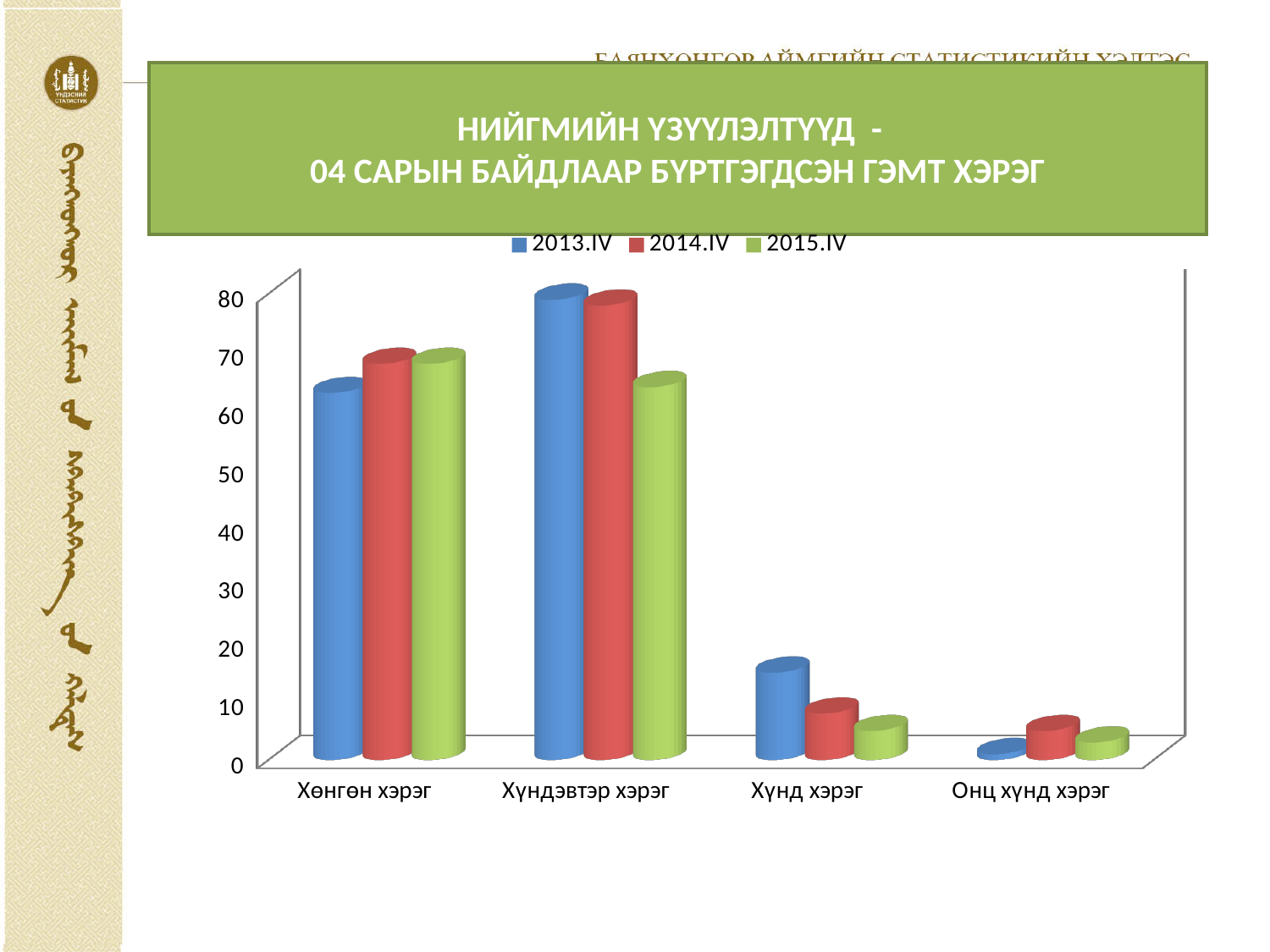
Which category has the highest value for the 2013.IV series? Хүндэвтэр хэрэг How many categories are shown on the x axis of the chart? 4 How many series does the chart legend list? 3 Is the 2013.IV value for Хөнгөн хэрэг greater or less than 50? greater Is the 2013.IV value for Хүндэвтэр хэрэг greater or less than 70? greater Which series are listed in the chart legend? 2013.IV, 2014.IV, 2015.IV For Хүнд хэрэг, which is larger: the 2013.IV value or the 2014.IV value? 2013.IV Which category has the lowest value for the 2013.IV series? Онц хүнд хэрэг Is the 2015.IV value for Хүндэвтэр хэрэг greater or less than 70? less What kind of chart is shown on the slide? bar chart For Хүндэвтэр хэрэг, which is larger: the 2013.IV value or the 2015.IV value? 2013.IV